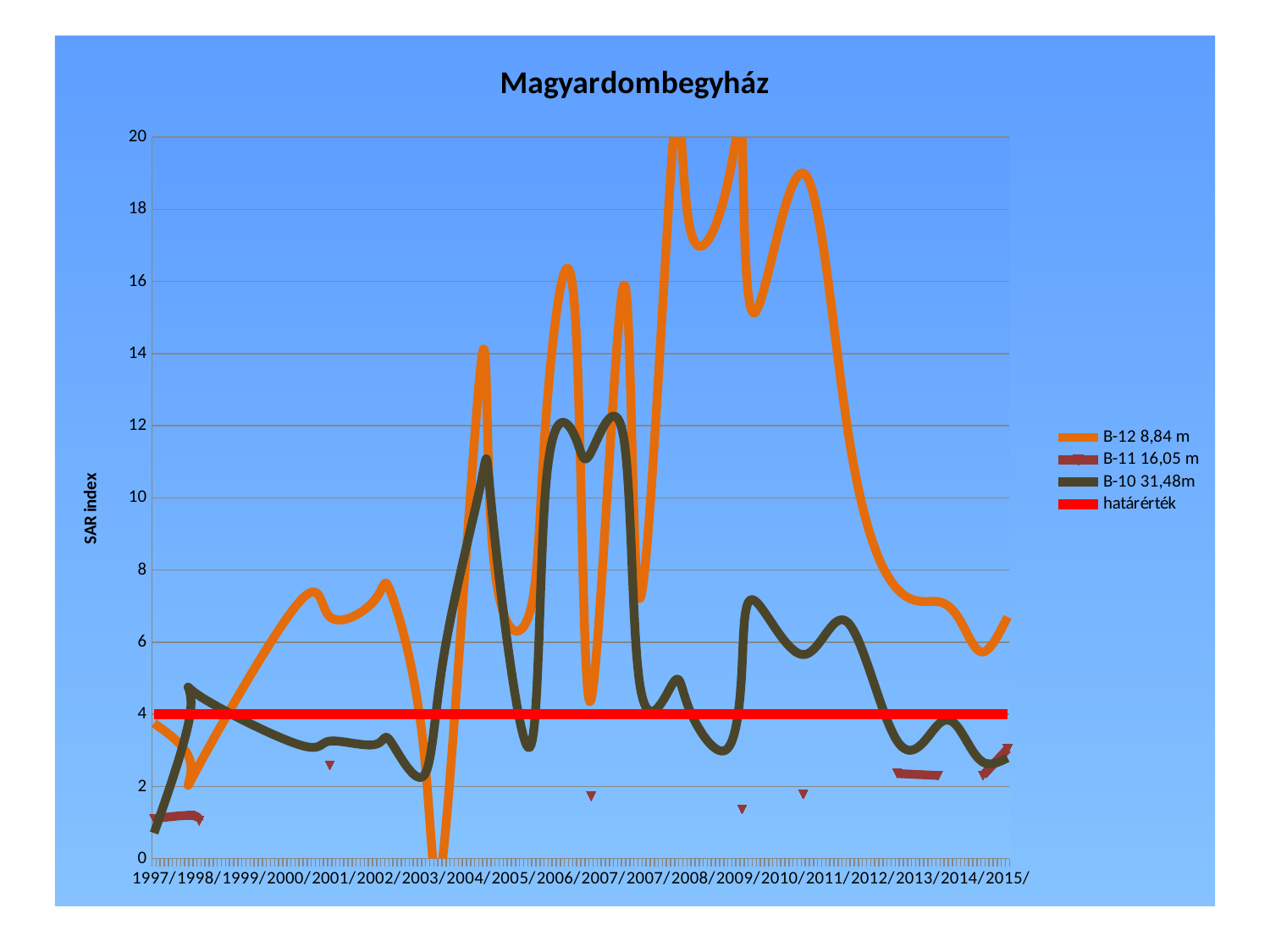
What type of chart is shown on the slide? line chart Is the peak value of the B-10 31,48m series around 2007 greater or less than 10? greater What is the title of the chart? Magyardombegyház What is the label of the y axis? SAR index Which series has the lowest values on the chart? B-11 16,05 m Is the peak value of the B-12 8,84 m series around 2008 greater or less than 18? greater Does the B-12 8,84 m series rise or fall between 2011 and 2014? fall How many series does the legend list? 4 At what value on the y axis does the határérték line sit? 4 Which series reaches the highest values on the chart? B-12 8,84 m Around 2008, which series is larger, B-12 8,84 m or B-10 31,48m? B-12 8,84 m